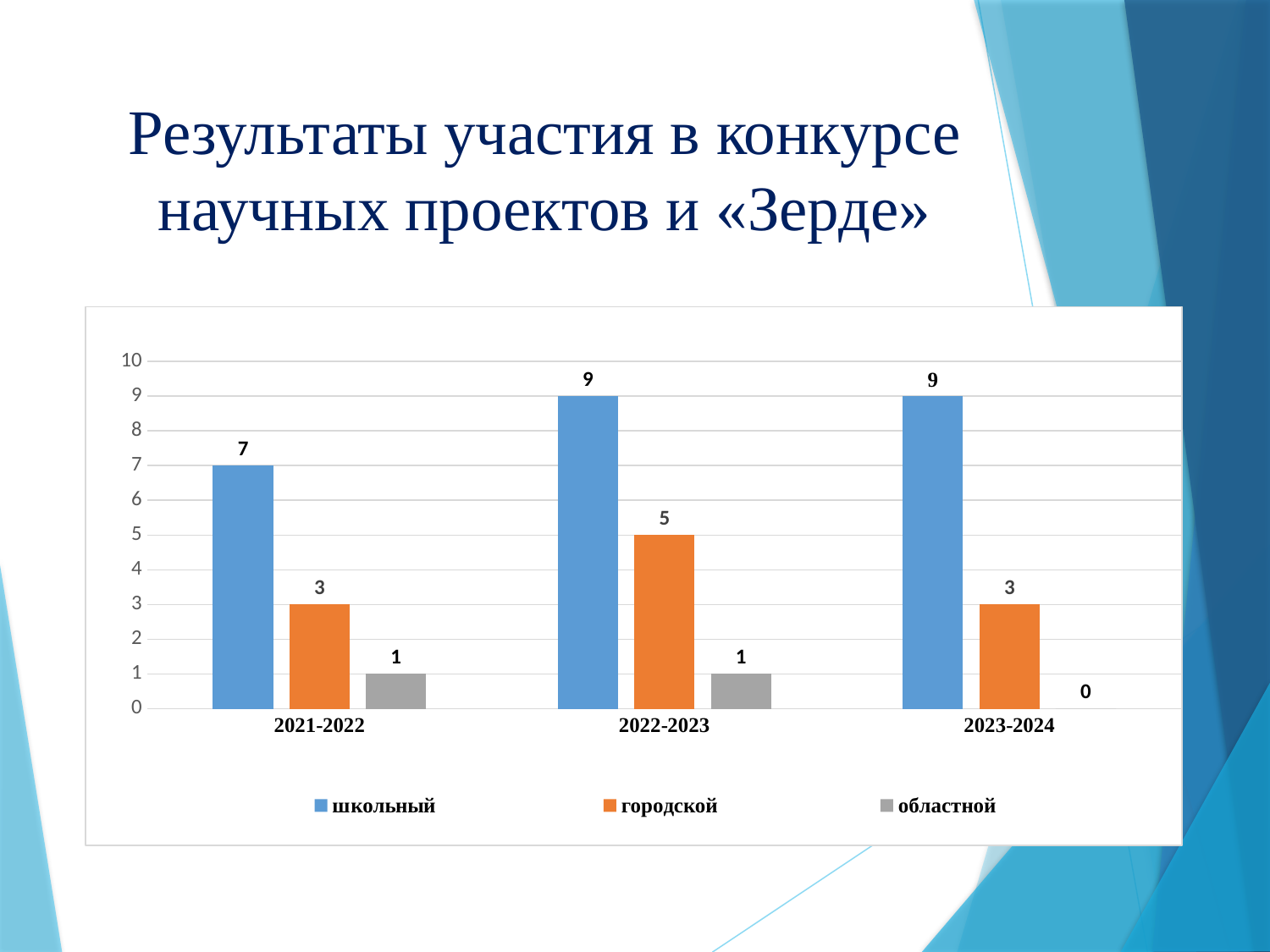
Is the value for школьный in 2023-2024 greater or less than 5? greater What is the value for городской in 2022-2023? 5 What is the value for областной in 2023-2024? 0 What is the value for школьный in 2021-2022? 7 How many year categories are shown on the x axis? 3 Which series is shown in orange in the legend? городской What is the difference between the школьный values for 2022-2023 and 2021-2022? 2 Which year has the lowest value for школьный? 2021-2022 How many series does the legend list? 3 Which is larger: городской in 2022-2023 or городской in 2023-2024? городской in 2022-2023 What kind of chart is shown on the slide? bar chart Which year has the highest value for городской? 2022-2023